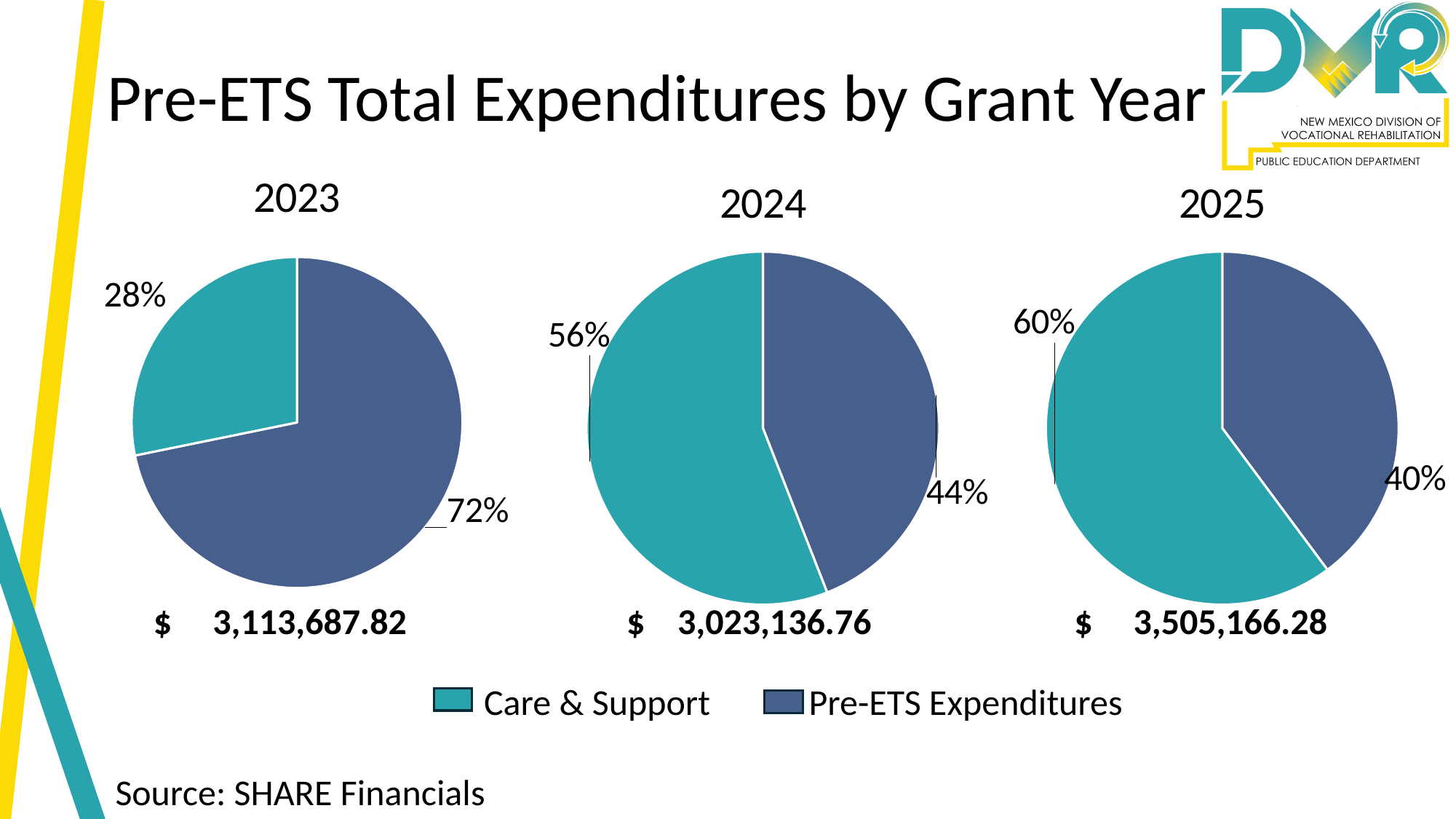
In the 2024 pie chart, what share does Care & Support have? 56% In the 2023 pie chart, what share does Care & Support have? 28% In the 2025 pie chart, which slice is the largest? Care & Support In the 2024 pie chart, what share does Pre-ETS Expenditures have? 44% In the 2023 pie chart, which slice is larger, Care & Support or Pre-ETS Expenditures? Pre-ETS Expenditures What kind of chart is used for each grant year on the slide? Pie chart How many series does the legend list? 2 What total amount is shown below the 2025 pie chart? $ 3,505,166.28 In the 2024 pie chart, what is the difference in percentage points between Care & Support and Pre-ETS Expenditures? 12